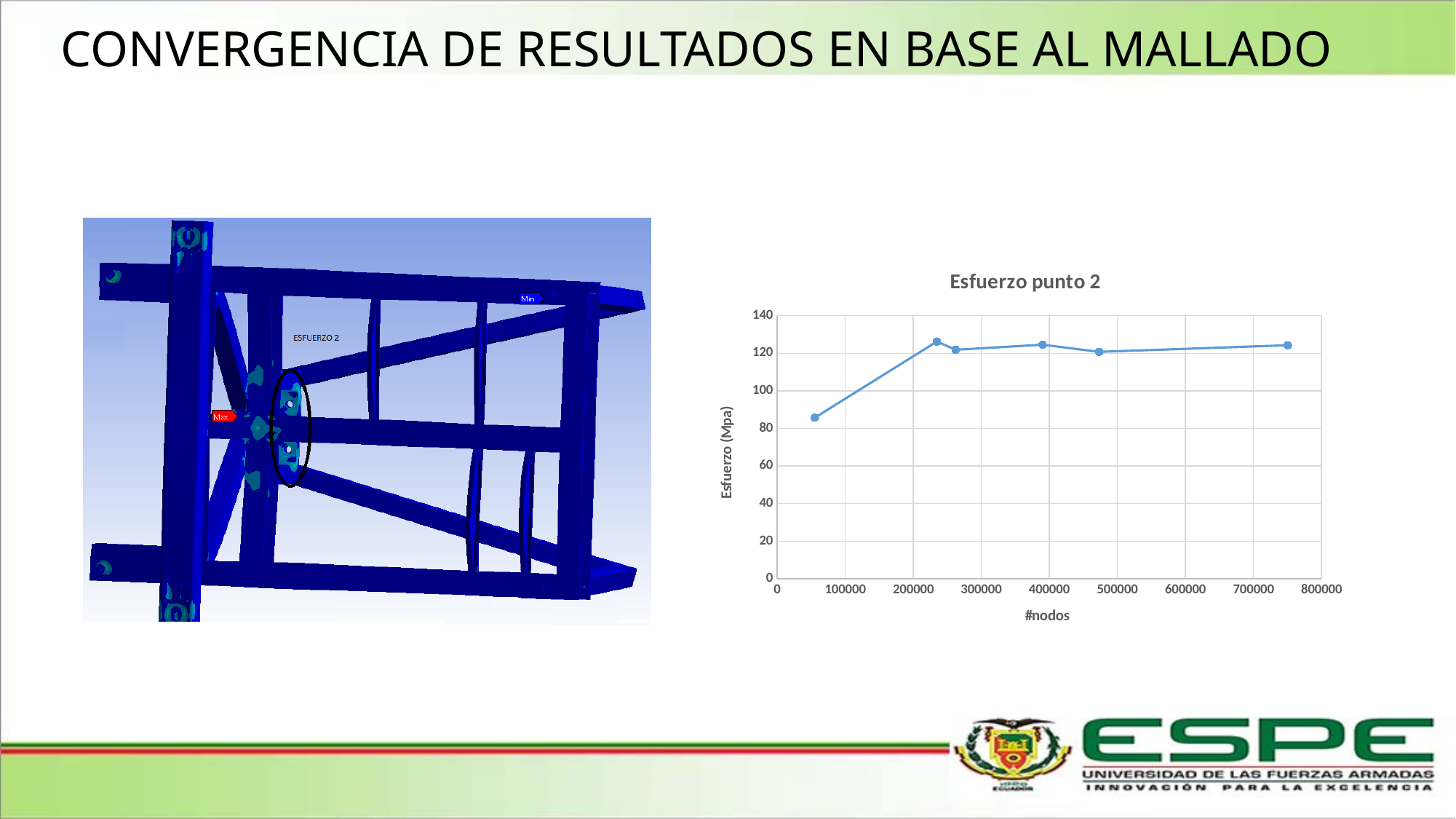
How many data points are plotted on the line in the chart? 6 Is the value of the data point near 400000 nodes greater or less than 140? less What is the label of the y axis of the chart? Esfuerzo (Mpa) Is the value of the last (rightmost) data point greater or less than 100? greater Which is larger, the value of the first data point or the value of the last data point? the last data point How does the Esfuerzo value change as the number of nodes increases from the first point to the second point? it rises Is the value of the data point near 500000 nodes greater or less than 100? greater After the second data point, do the values change strongly or stay roughly level as the number of nodes increases? stay roughly level Which data point has the lowest Esfuerzo value? the first (leftmost) point, near 50000 nodes What kind of chart is shown on the slide? line chart What is the title of the chart? Esfuerzo punto 2